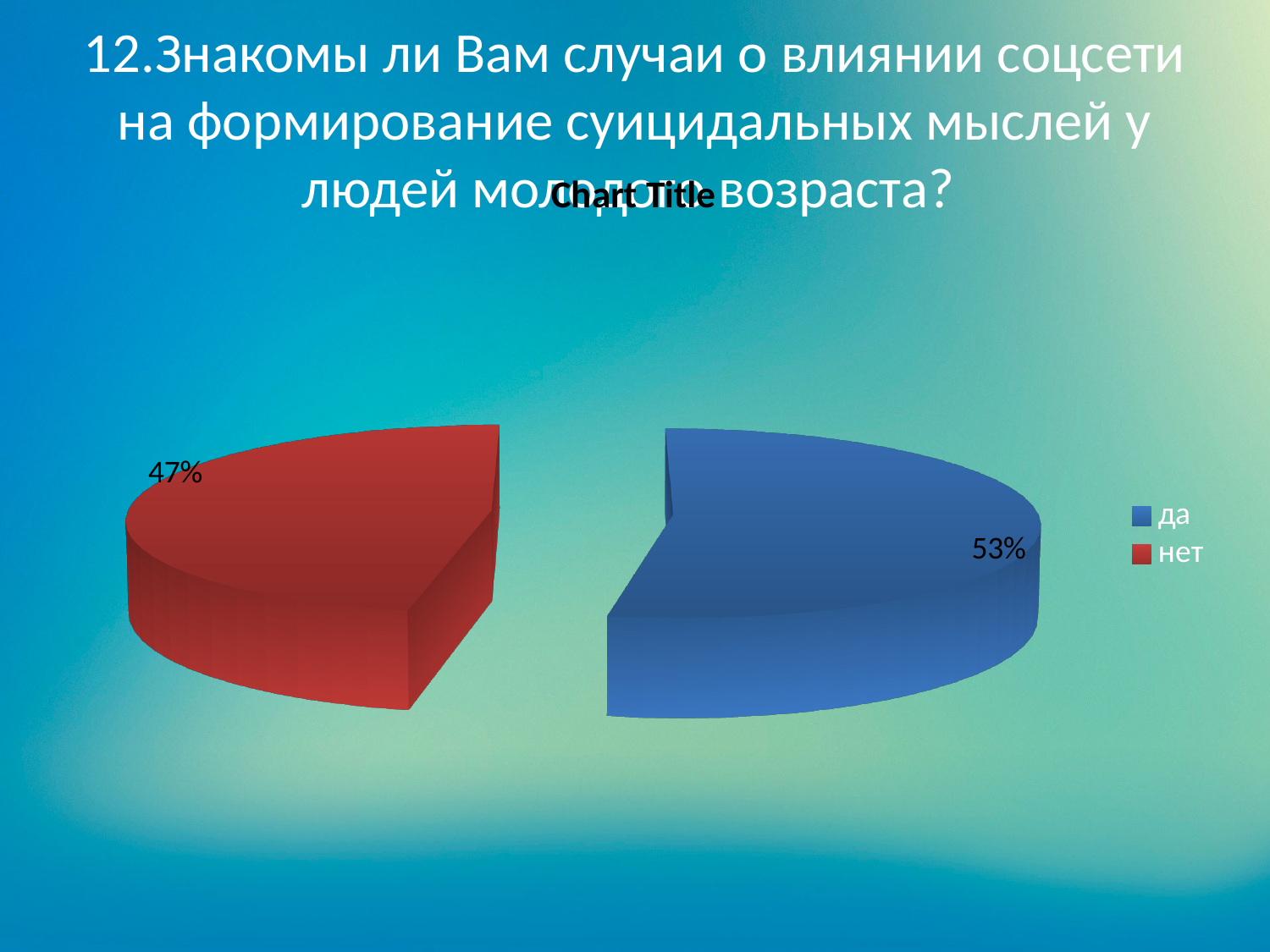
Is the share for "да" greater or less than 50%? greater Which category has the largest share of the pie? да Which category has the smallest share of the pie? нет What percentage of the pie is labelled for "нет"? 47% What percentage of the pie is labelled for "да"? 53% Which is larger, the share for "да" or the share for "нет"? да What is the difference in percentage points between the "да" and "нет" slices? 6 How many entries does the legend list? 2 What is the title shown above the pie chart? Chart Title What kind of chart is shown on the slide? pie chart How many slices does the pie chart have? 2 What colour is the slice for "нет"? red